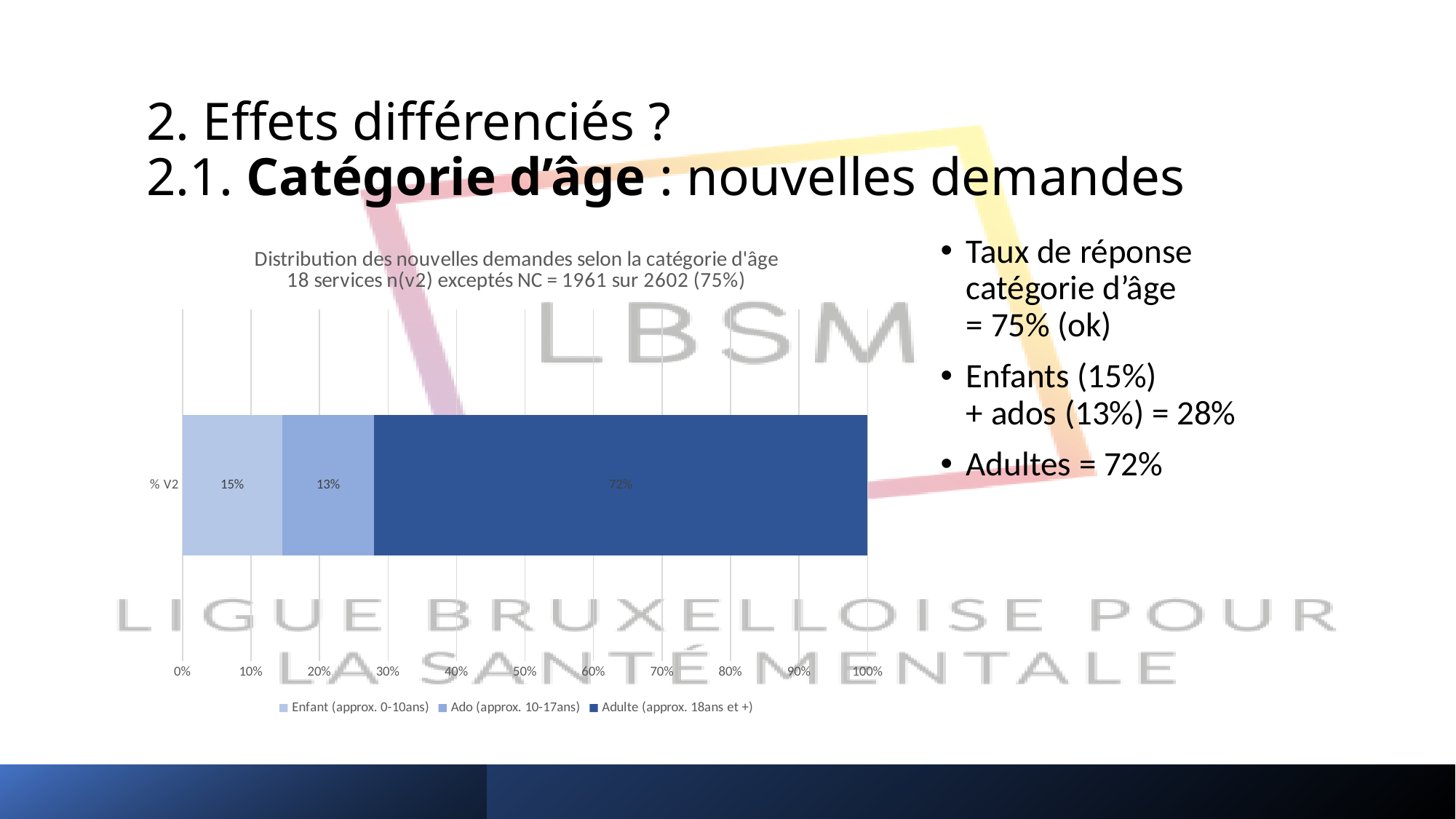
Which series has the largest share of the stacked bar? Adulte (approx. 18ans et +) What is the combined share of Enfant and Ado? 28% What kind of chart is shown on the slide? Stacked bar chart Is the Adulte share greater or less than 70%? greater What percentage of new requests is shown for the Enfant (approx. 0-10ans) series? 15% How many series does the legend list? 3 What is the label of the single category on the vertical axis? % V2 What percentage of new requests is shown for the Adulte (approx. 18ans et +) series? 72% What is the difference between the Adulte share and the Enfant share? 57% Which series has the smallest share of the stacked bar? Ado (approx. 10-17ans) Which is larger, the Enfant share or the Ado share? Enfant What percentage of new requests is shown for the Ado (approx. 10-17ans) series? 13%